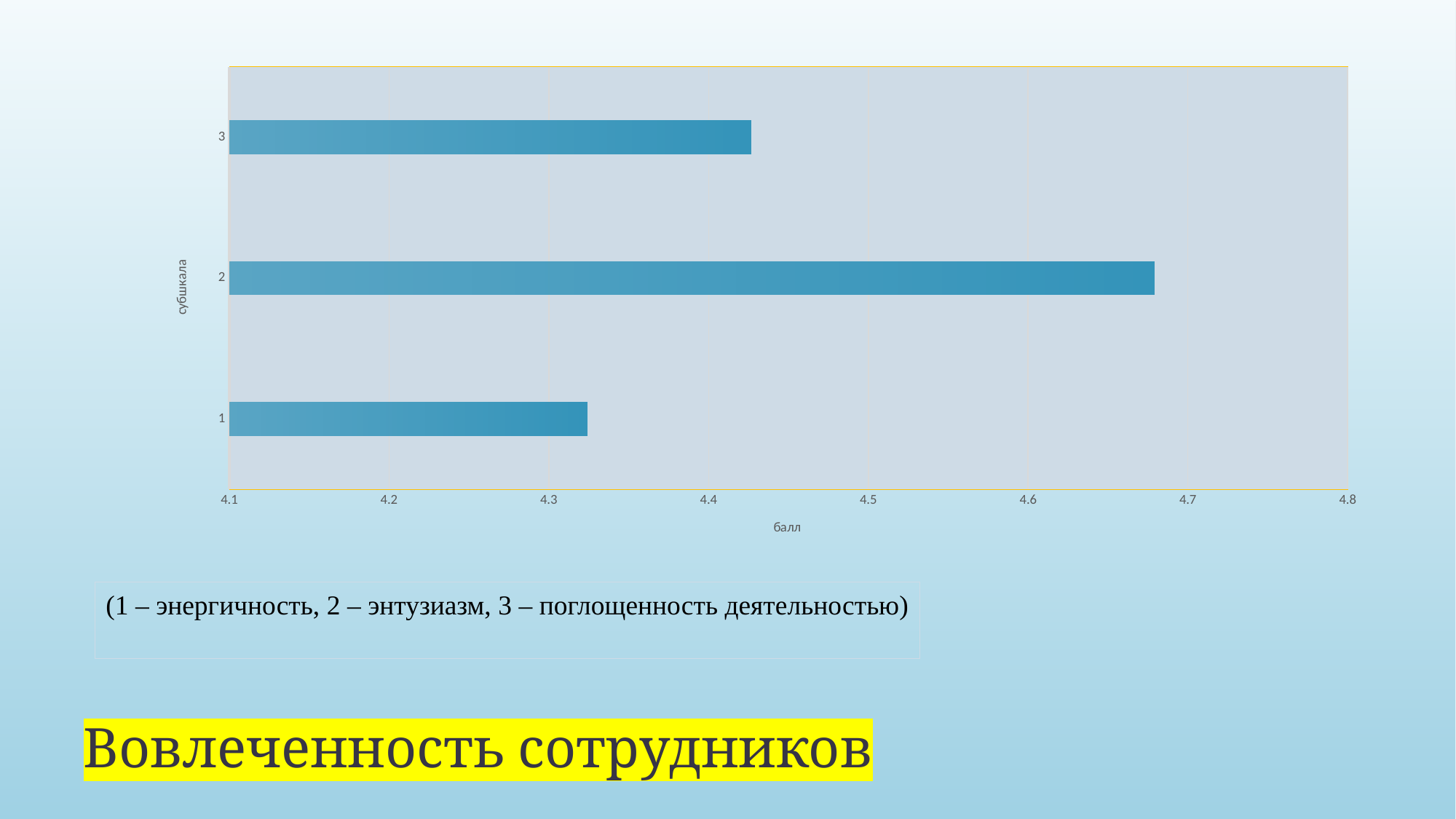
Which subscale has the highest score (балл)? 2 Which has the larger score, subscale 2 or subscale 3? 2 What kind of chart is shown on the slide? bar chart Is the value for subscale 2 greater or less than 4.6? greater How many bars (subscales) are plotted in the chart? 3 Is the value for subscale 3 greater or less than 4.5? less What is the label of the horizontal (value) axis of the chart? балл Which subscale has the lowest score (балл)? 1 Is the value for subscale 1 greater or less than 4.4? less Which has the larger score, subscale 1 or subscale 3? 3 What is the label of the vertical (category) axis of the chart? субшкала